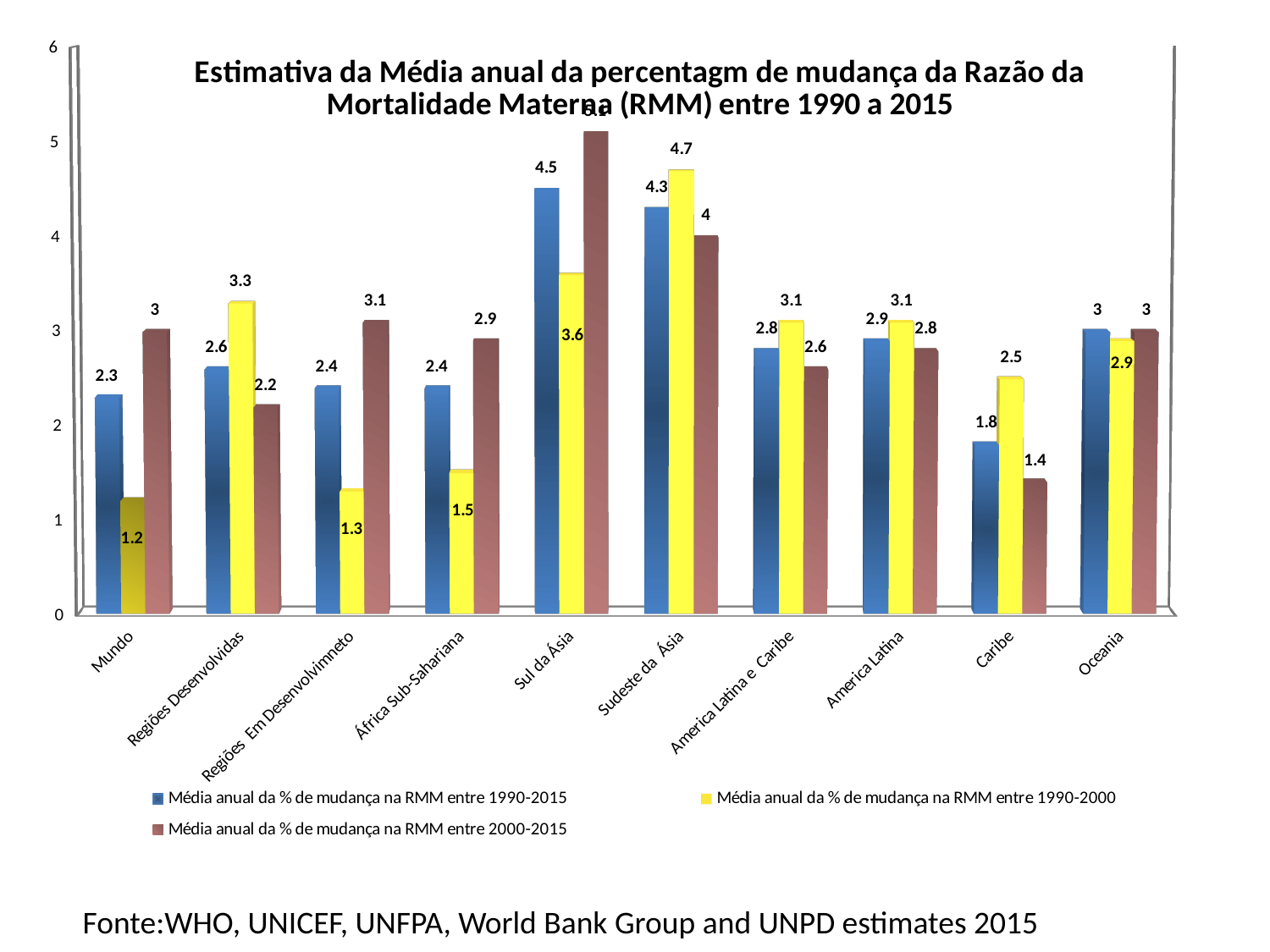
What is the value for Caribe in the series 'Média anual da % de mudança na RMM entre 2000-2015'? 1.4 Which region has the highest value in the series 'Média anual da % de mudança na RMM entre 1990-2015'? Sul da Ásia Which region has the lowest value in the series 'Média anual da % de mudança na RMM entre 1990-2000'? Mundo What is the difference between the 1990-2000 value and the 2000-2015 value for Caribe? 1.1 What is the value for Mundo in the series 'Média anual da % de mudança na RMM entre 1990-2000'? 1.2 What colour represents the series 'Média anual da % de mudança na RMM entre 1990-2000'? yellow How many regions (categories) are shown on the x axis? 10 For Sudeste da Ásia, which is larger: the 1990-2000 value or the 2000-2015 value? 1990-2000 How many series does the legend list? 3 Is the value for Sul da Ásia in the series 'Média anual da % de mudança na RMM entre 2000-2015' greater or less than 5? greater What is the value for Regiões Desenvolvidas in the series 'Média anual da % de mudança na RMM entre 1990-2015'? 2.6 What type of chart is shown on the slide? bar chart